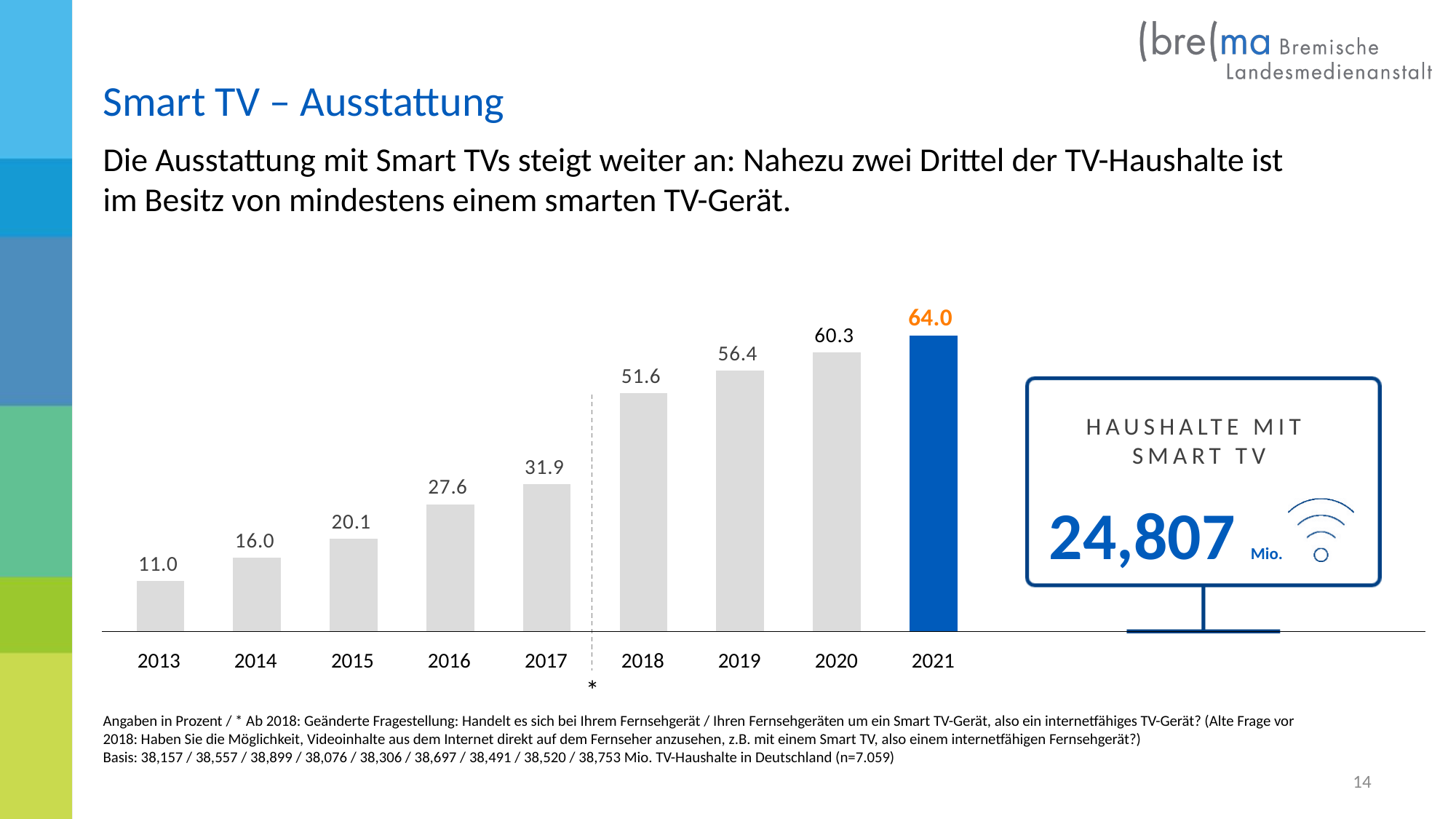
How many years are shown on the x axis? 9 What is the value for 2017? 31.9 Which is larger, the value for 2016 or the value for 2019? 2019 Which year has the lowest value? 2013 What kind of chart is shown on the slide? bar chart What is the difference between the values for 2018 and 2017? 19.7 Which bar is highlighted in blue rather than grey? 2021 What is the value for 2013? 11.0 Do the values rise or fall from 2013 to 2021? rise What is the value for 2021? 64.0 Which year has the highest value? 2021 What is the difference between the values for 2021 and 2020? 3.7